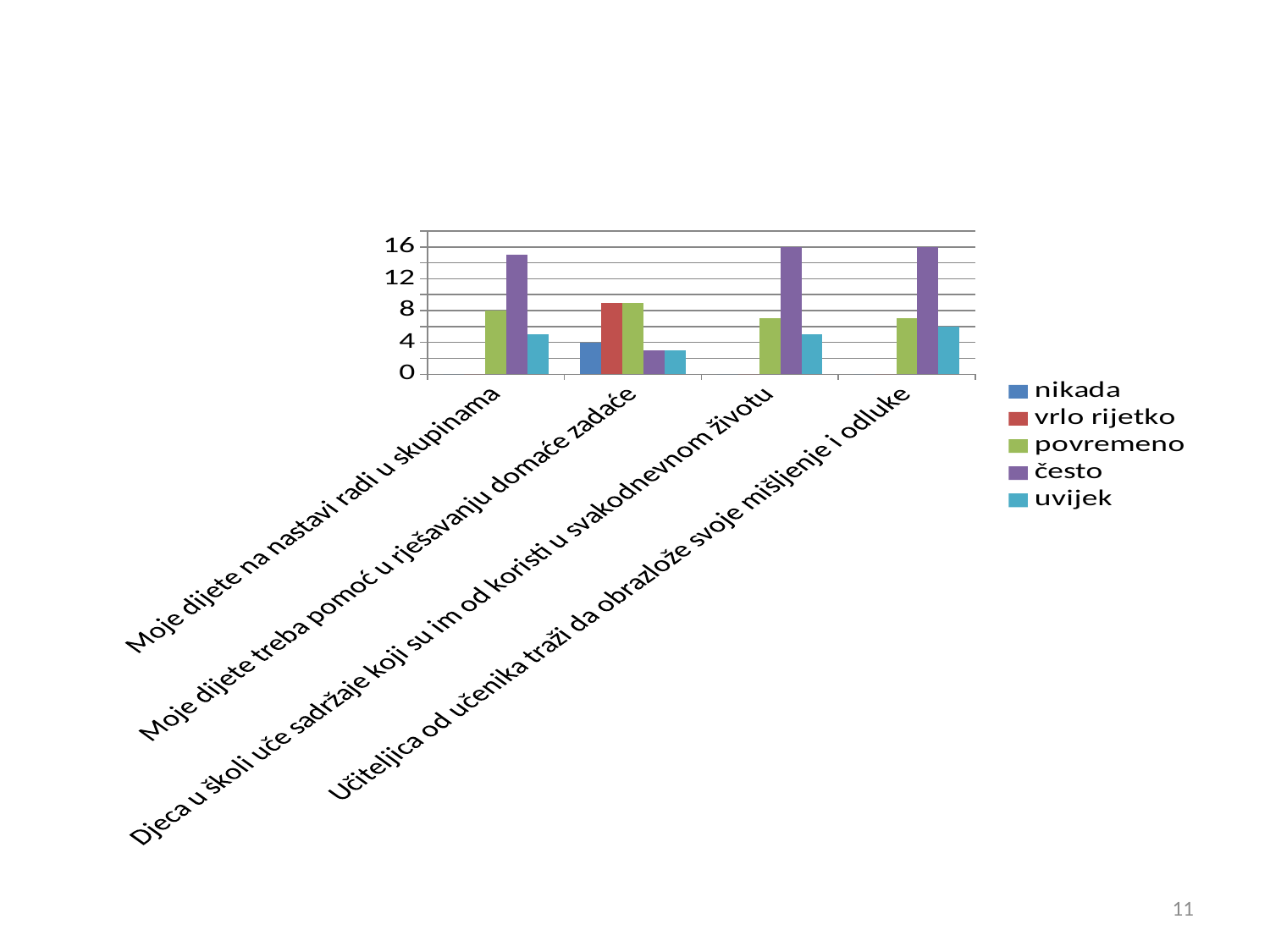
What is the value of 'često' for 'Djeca u školi uče sadržaje koji su im od koristi u svakodnevnom životu'? 16 What is the value of 'povremeno' for 'Moje dijete na nastavi radi u skupinama'? 8 How many categories are shown on the x axis? 4 What kind of chart is shown on the slide? bar chart Is the value of 'često' for 'Moje dijete na nastavi radi u skupinama' greater or less than 12? greater Which series has the highest value for 'Učiteljica od učenika traži da obrazlože svoje mišljenje i odluke'? često Is the value of 'često' for 'Moje dijete treba pomoć u rješavanju domaće zadaće' greater or less than 4? less What is the value of 'nikada' for 'Moje dijete treba pomoć u rješavanju domaće zadaće'? 4 How many series does the legend list? 5 Which legend entry is shown in purple? često For 'Moje dijete treba pomoć u rješavanju domaće zadaće', which is larger: 'vrlo rijetko' or 'često'? vrlo rijetko